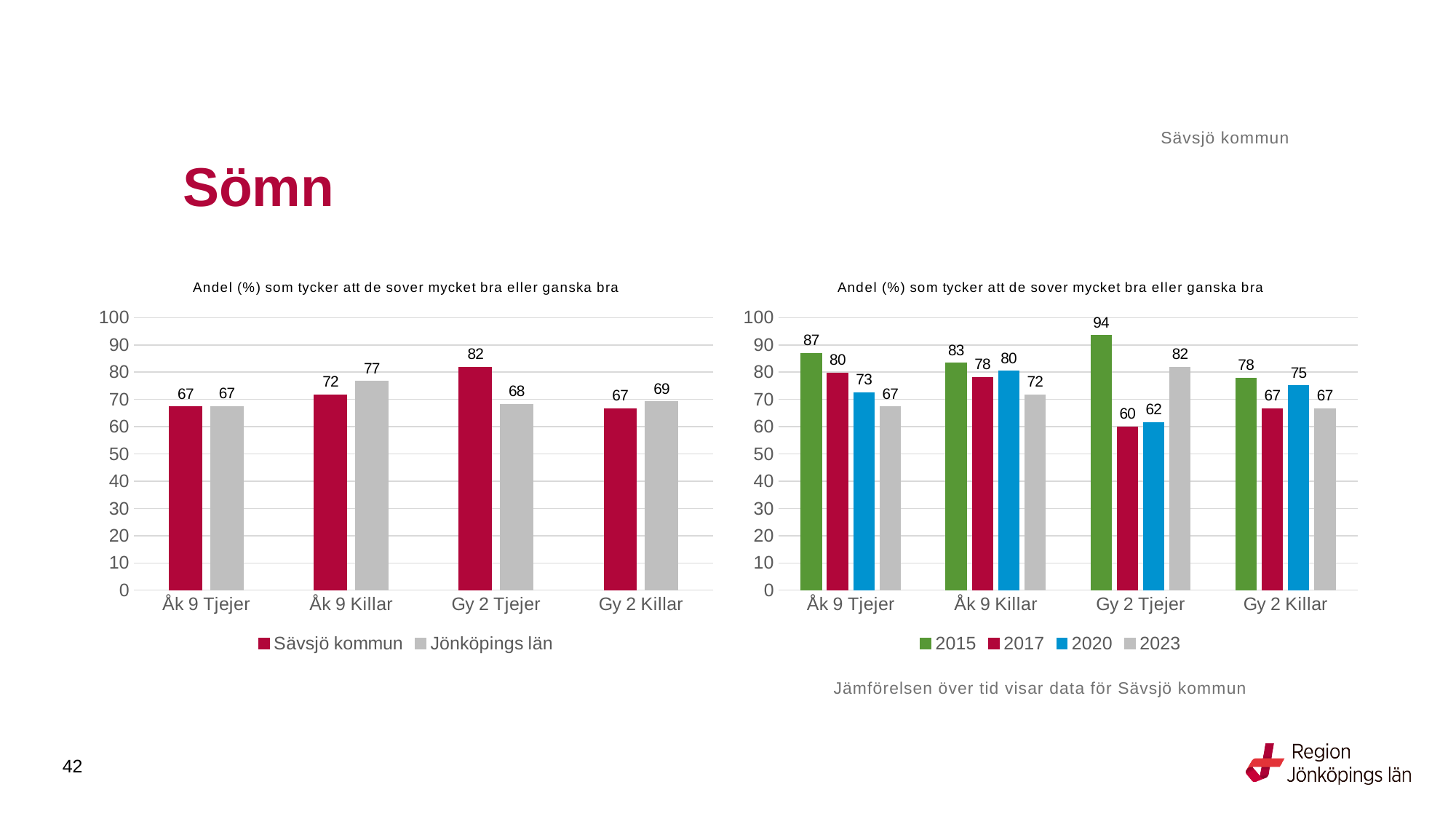
In the left chart, what is the value for Sävsjö kommun for Gy 2 Tjejer? 82 In the right chart, what is the value for 2015 for Gy 2 Tjejer? 94 In the left chart, what is the value for Jönköpings län for Åk 9 Killar? 77 In the right chart, what is the difference between the 2015 and 2023 values for Åk 9 Tjejer? 20 In the left chart, which category has the highest value for Sävsjö kommun? Gy 2 Tjejer In the right chart, which year has the lowest value for Gy 2 Tjejer? 2017 What kind of chart is the right chart? Bar chart In the right chart, how many series does the legend list? 4 In the right chart, what is the value for 2020 for Åk 9 Killar? 80 In the left chart, how many series does the legend list? 2 In the left chart, what is the difference between Sävsjö kommun and Jönköpings län for Gy 2 Tjejer? 14 In the right chart, which is larger for Åk 9 Tjejer: the value for 2017 or the value for 2023? 2017